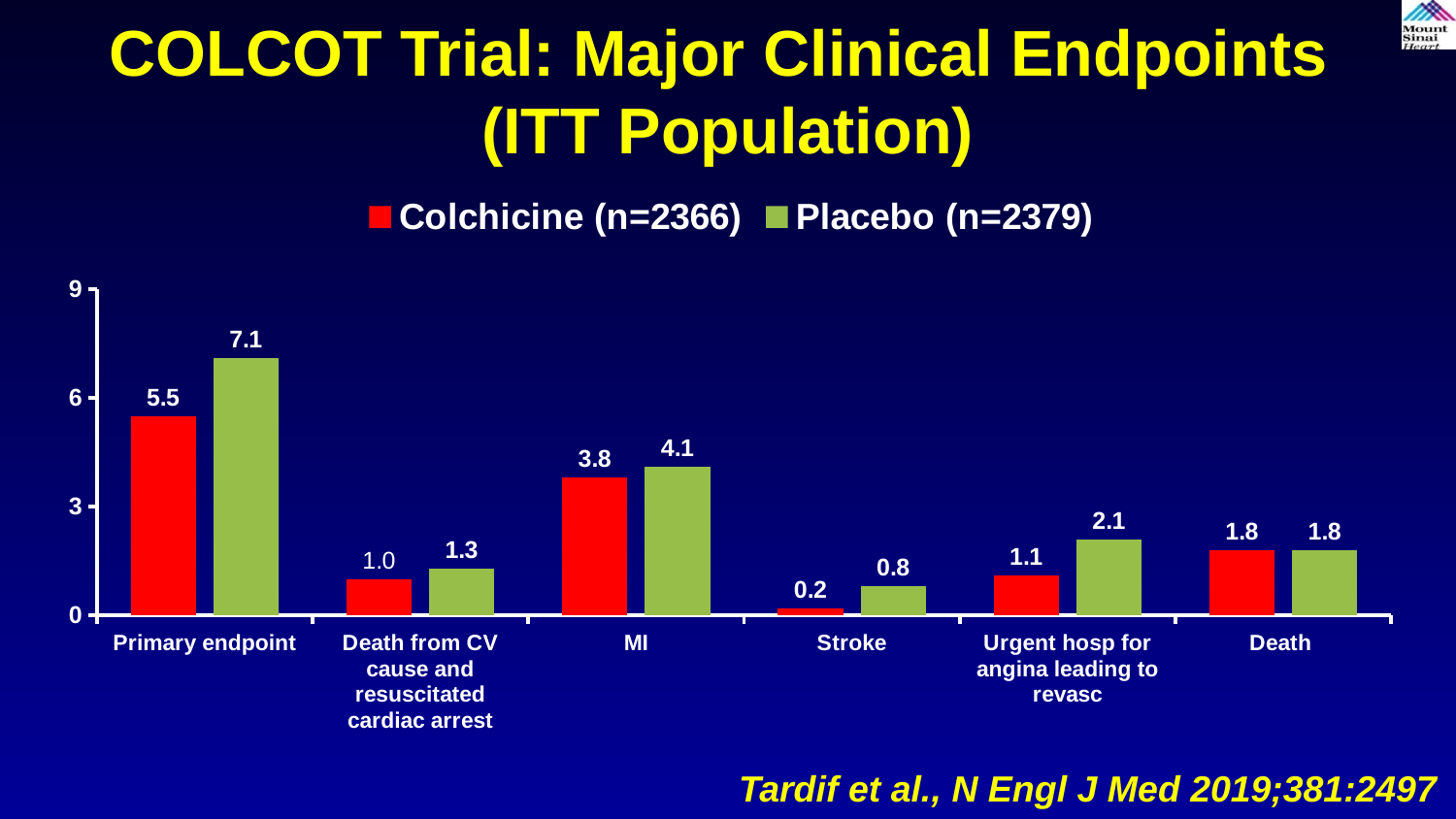
How many series does the legend list? 2 How many categories are shown on the x axis? 6 What is the Placebo (n=2379) value for MI? 4.1 Which is larger for Stroke: the Colchicine (n=2366) value or the Placebo (n=2379) value? Placebo (n=2379) What is the Colchicine (n=2366) value for Stroke? 0.2 What is the Colchicine (n=2366) value for the Primary endpoint? 5.5 Which category has the highest Placebo (n=2379) value? Primary endpoint What is the Placebo (n=2379) value for Urgent hosp for angina leading to revasc? 2.1 What kind of chart is shown on the slide? Bar chart Which category has the lowest Colchicine (n=2366) value? Stroke What colour are the Placebo (n=2379) bars? Green What is the difference between the Placebo (n=2379) and Colchicine (n=2366) values for the Primary endpoint? 1.6